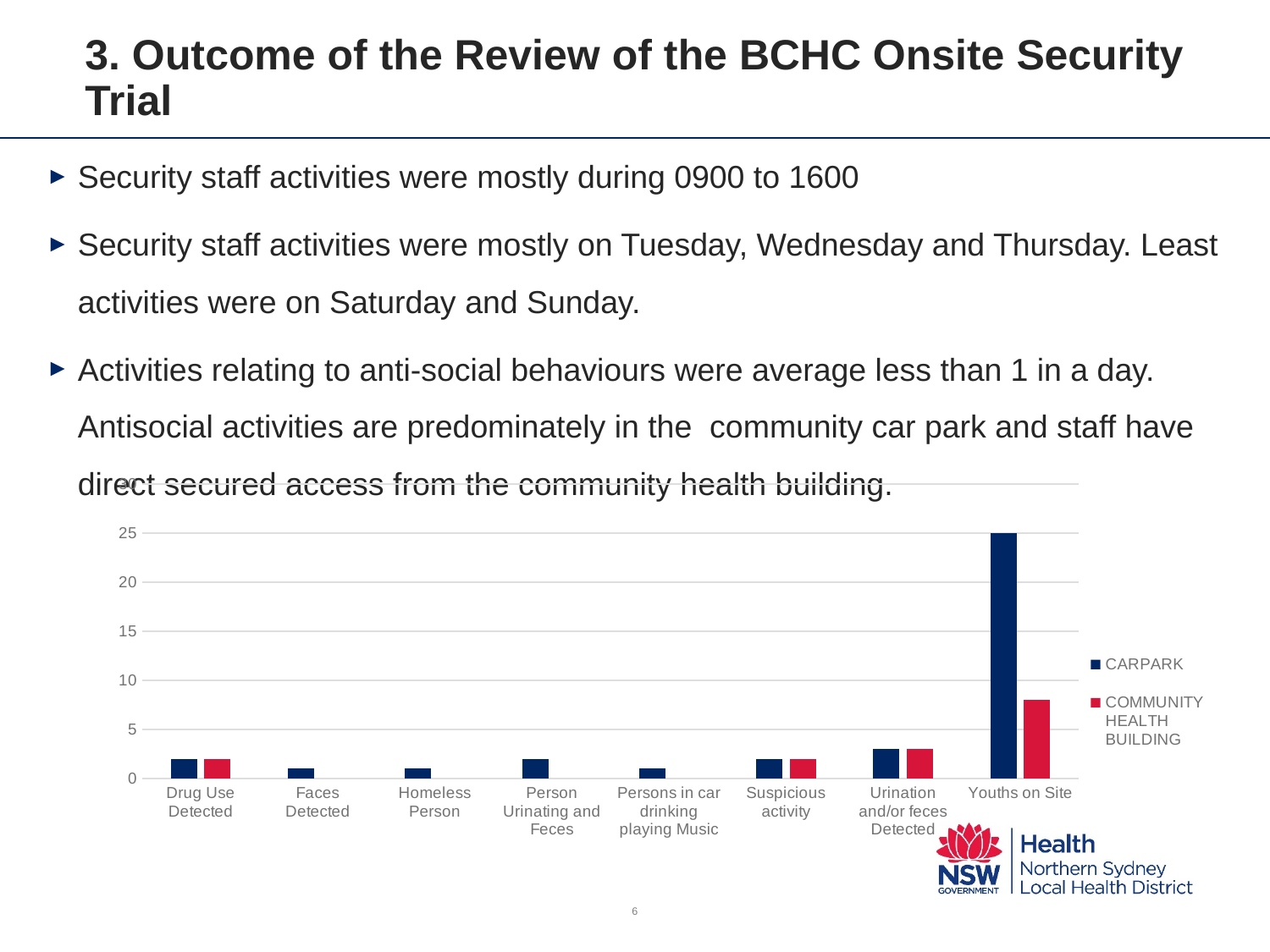
Is the COMMUNITY HEALTH BUILDING value for Youths on Site greater or less than 5? greater Which has the larger CARPARK value, Urination and/or feces Detected or Homeless Person? Urination and/or feces Detected How many categories are shown along the x axis of the chart? 8 What is the CARPARK value for Youths on Site? 25 What are the two series named in the chart's legend? CARPARK and COMMUNITY HEALTH BUILDING Which category has the highest CARPARK value? Youths on Site How many series does the chart's legend list? 2 What kind of chart is shown on the slide? bar chart Which series is shown in red in the chart? COMMUNITY HEALTH BUILDING For Youths on Site, which series has the larger value, CARPARK or COMMUNITY HEALTH BUILDING? CARPARK Is the CARPARK value for Youths on Site greater or less than 20? greater Is the CARPARK value for Urination and/or feces Detected greater or less than 5? less